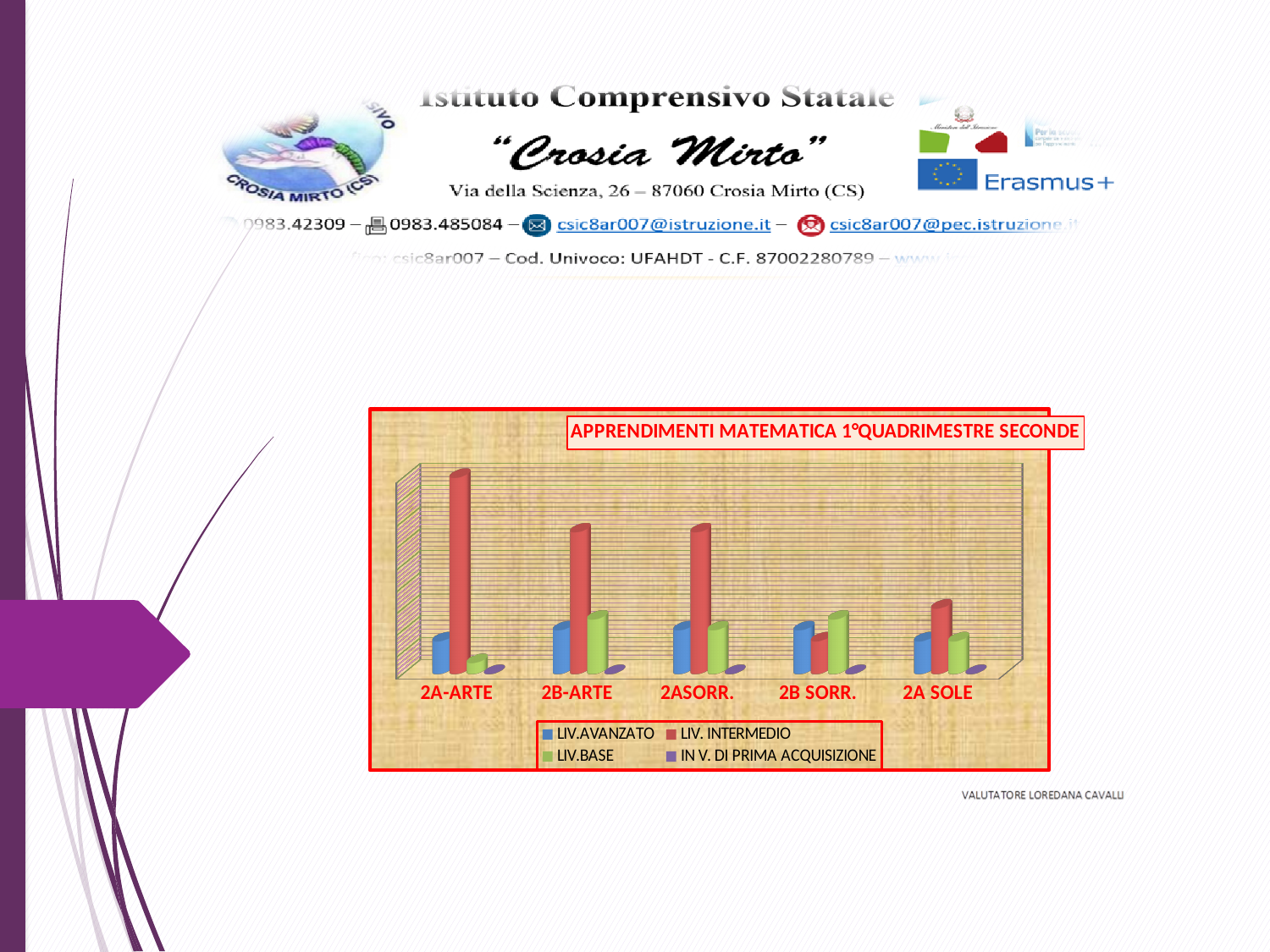
In 2B SORR., which is larger: LIV.BASE or LIV. INTERMEDIO? LIV.BASE In 2A SOLE, which is larger: LIV. INTERMEDIO or LIV.AVANZATO? LIV. INTERMEDIO What is the title of the chart? APPRENDIMENTI MATEMATICA 1°QUADRIMESTRE SECONDE Which class has the lowest LIV. INTERMEDIO bar? 2B SORR. In 2A-ARTE, which is larger: LIV. INTERMEDIO or LIV.AVANZATO? LIV. INTERMEDIO How many series does the chart legend list? 4 Which series has the tallest bar in the 2B SORR. category? LIV.BASE Which series has the smallest bar in every category? IN V. DI PRIMA ACQUISIZIONE Which class has the highest LIV. INTERMEDIO bar? 2A-ARTE What kind of chart is shown on the slide? bar chart How many classes (categories) are shown on the x axis of the chart? 5 Which series are listed in the chart legend? LIV.AVANZATO, LIV. INTERMEDIO, LIV.BASE, IN V. DI PRIMA ACQUISIZIONE